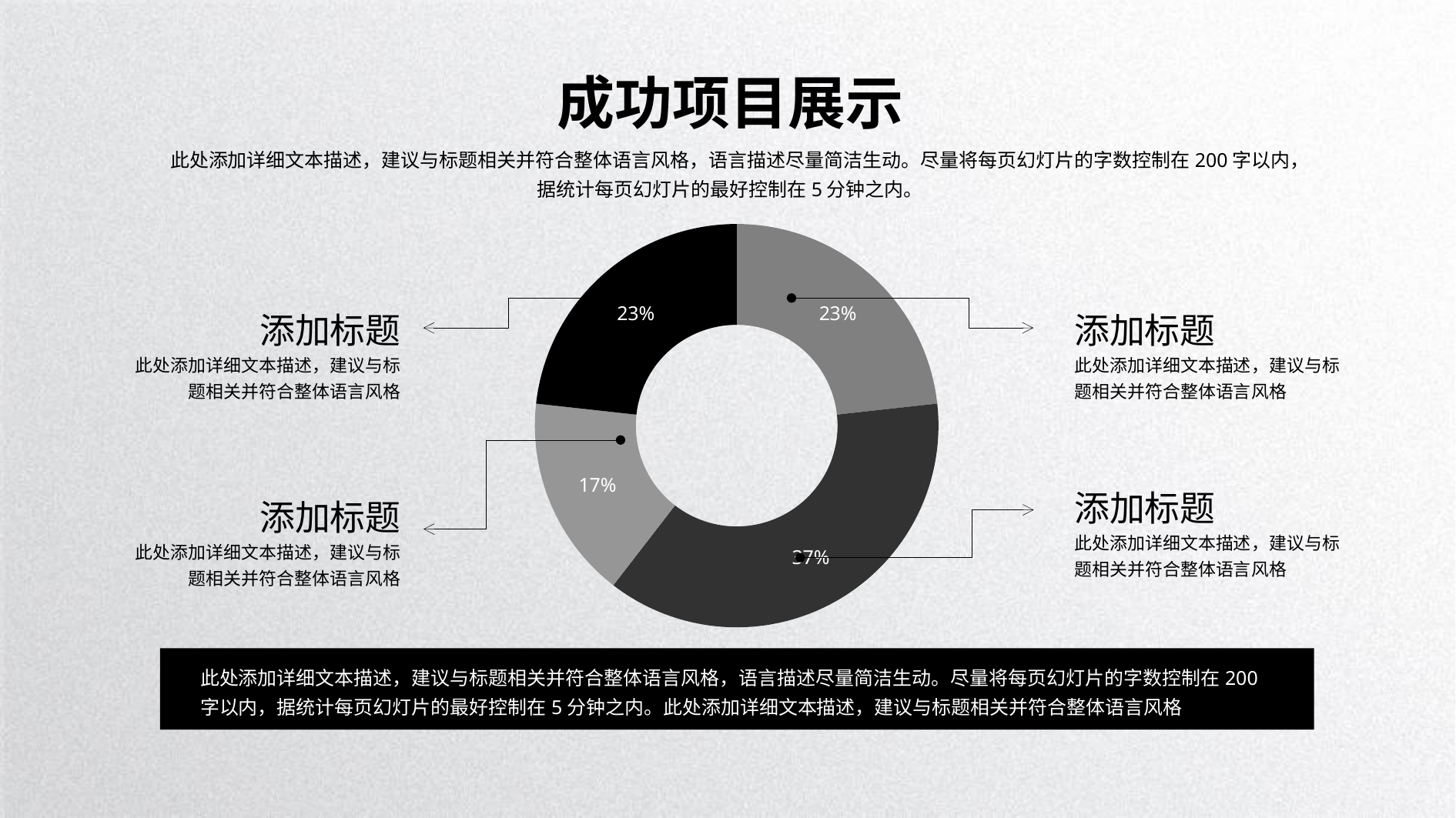
What is the value of the largest slice in the doughnut chart? 37% What is the value of the smallest slice in the doughnut chart? 17% What kind of chart is shown on the slide? doughnut chart What is the title of the slide containing the doughnut chart? 成功项目展示 How many slices does the doughnut chart have? 4 How many slices in the doughnut chart are labelled 23%? 2 What percentage is shown on the black slice at the top left of the doughnut chart? 23% What is the difference between the largest slice (37%) and the smallest slice (17%) in the doughnut chart? 20% Which is larger in the doughnut chart: the bottom dark gray slice or the left light gray slice? the bottom dark gray slice What percentage is shown on the light gray slice at the left of the doughnut chart? 17% What percentage is shown on the dark gray slice at the bottom of the doughnut chart? 37% What percentage is shown on the gray slice at the top right of the doughnut chart? 23%